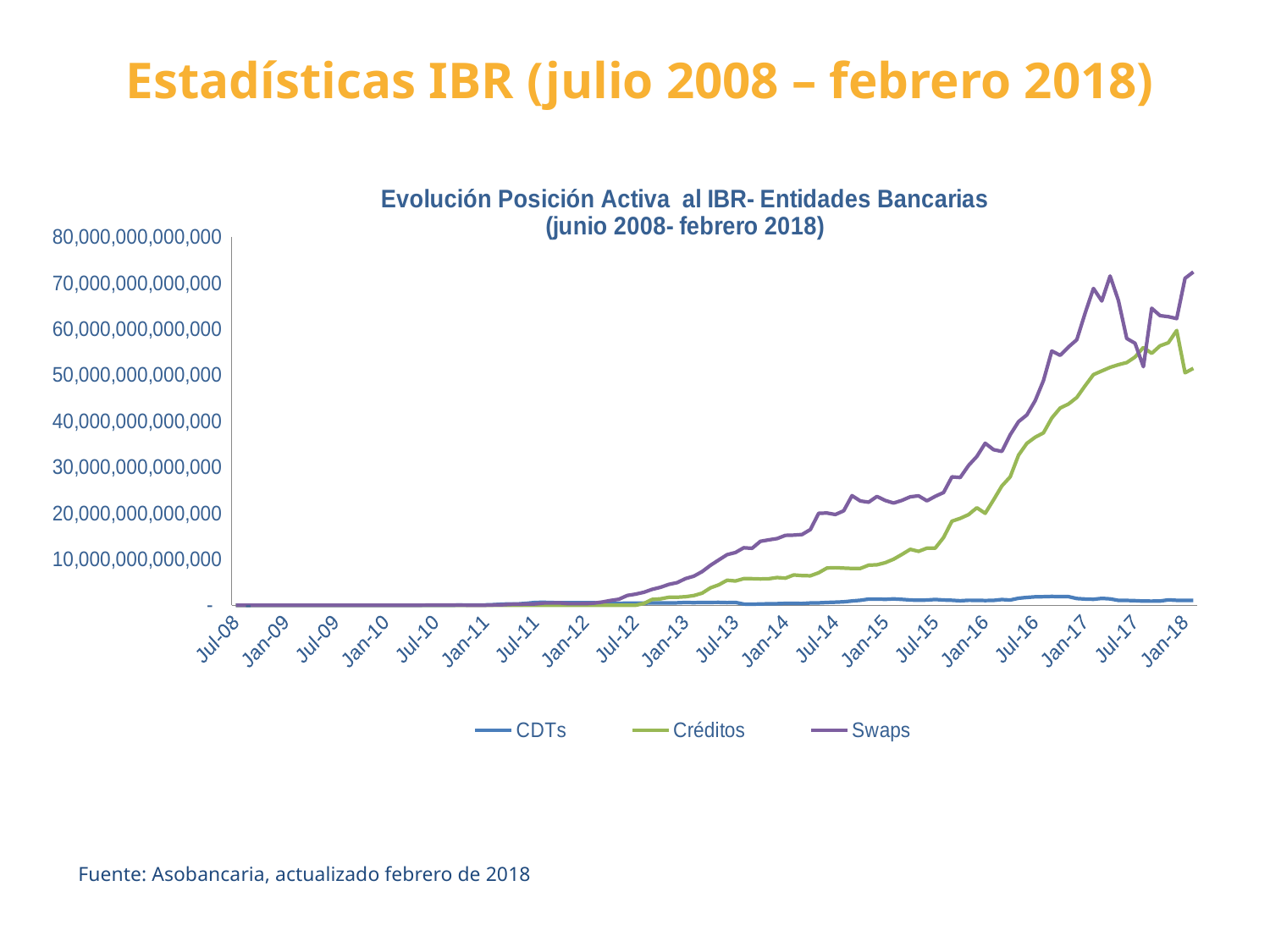
How many series does the legend list? 3 Is the value for Swaps at Jan-18 greater or less than 60,000,000,000,000? greater Which series is drawn in purple? Swaps What is the title of the chart? Evolución Posición Activa al IBR- Entidades Bancarias (junio 2008- febrero 2018) Which series reaches the highest value on the chart? Swaps At Jan-15, which is larger, Swaps or CDTs? Swaps Is the value for Créditos at Jan-17 greater or less than 40,000,000,000,000? greater What kind of chart is shown on the slide? Line chart At Jan-18, which is larger, Swaps or Créditos? Swaps Overall, does the Swaps series rise or fall from Jul-08 to Jan-18? Rise Is the value for CDTs at Jan-18 greater or less than 10,000,000,000,000? less